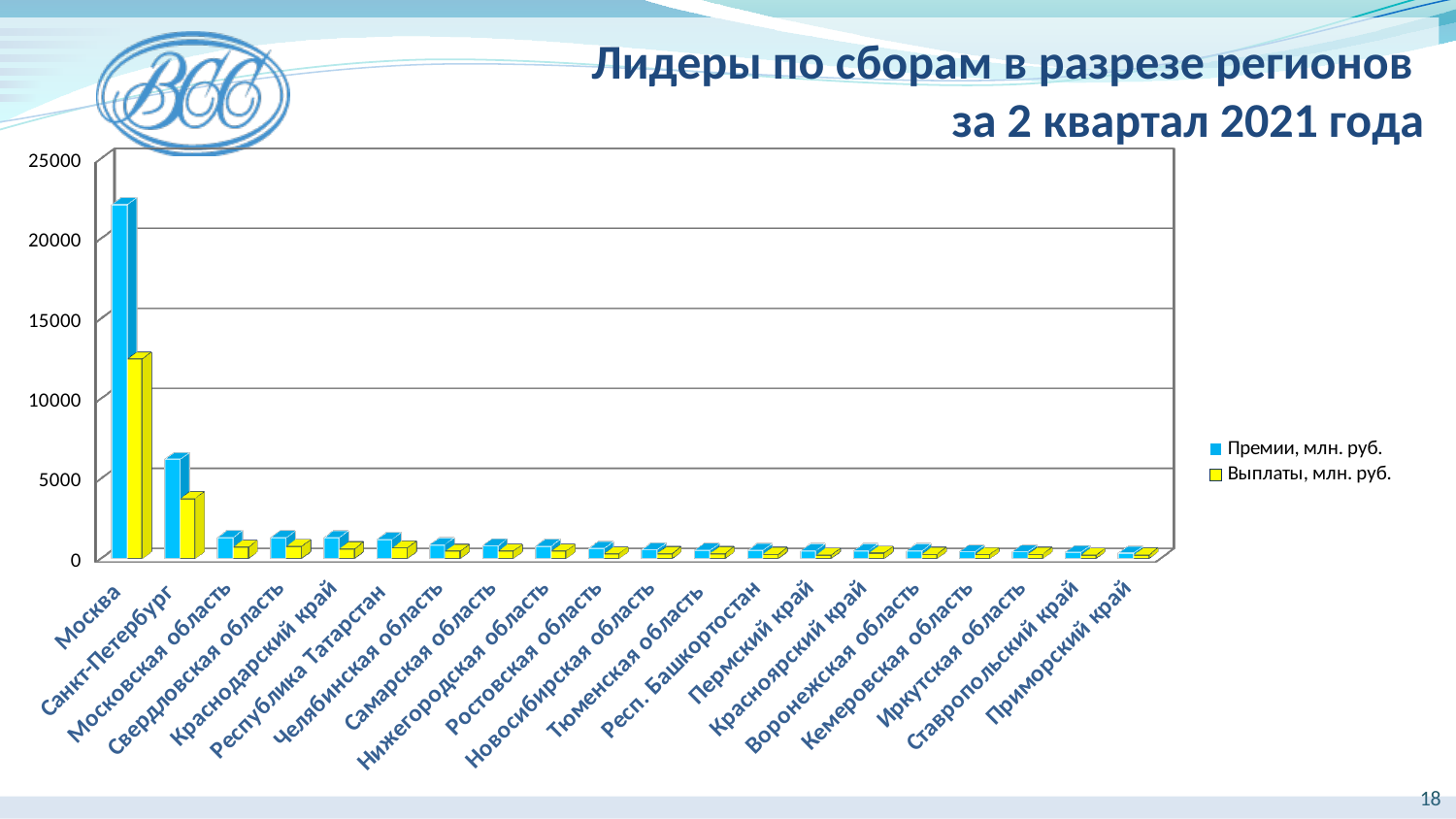
How many regions are shown on the x axis of the chart? 20 Which is larger for Москва: Премии, млн. руб. or Выплаты, млн. руб.? Премии, млн. руб. Do the values of Премии, млн. руб. rise or fall moving from left to right along the x axis? fall Is the value of Премии, млн. руб. for Санкт-Петербург greater or less than 5000? greater What kind of chart is shown on the slide? bar chart Is the value of Выплаты, млн. руб. for Санкт-Петербург greater or less than 5000? less Is the value of Премии, млн. руб. for Москва greater or less than 20000? greater Which region has the highest value for Премии, млн. руб.? Москва What is the title of the chart on the slide? Лидеры по сборам в разрезе регионов за 2 квартал 2021 года How many series does the legend list? 2 Which region has the lowest value for Премии, млн. руб.? Приморский край